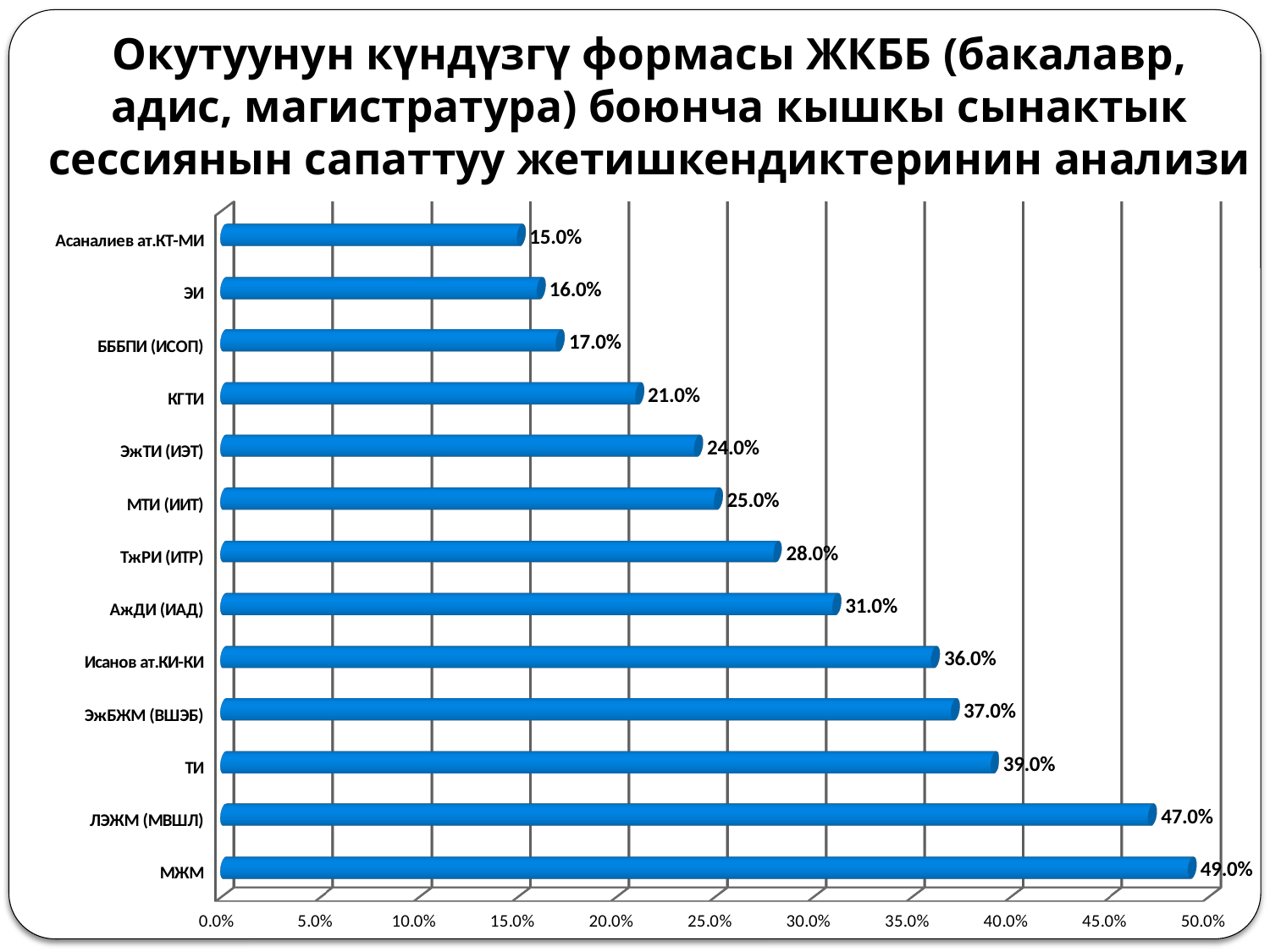
How many categories are shown in the chart? 13 What is the value for ЭжТИ (ИЭТ)? 24.0% What kind of chart is shown on the slide? bar chart Is the value for ЭжБЖМ (ВШЭБ) greater or less than 30.0%? greater What is the difference between the values for АжДИ (ИАД) and ЭИ? 15.0% Which category has the highest value? МЖМ What is the difference between the values for ЛЭЖМ (МВШЛ) and ТИ? 8.0% Which is larger, the value for ТжРИ (ИТР) or the value for МТИ (ИИТ)? ТжРИ (ИТР) Which category has the lowest value? Асаналиев ат.КТ-МИ What is the value for КГТИ? 21.0% What is the value for Исанов ат.КИ-КИ? 36.0% What is the value for МЖМ? 49.0%